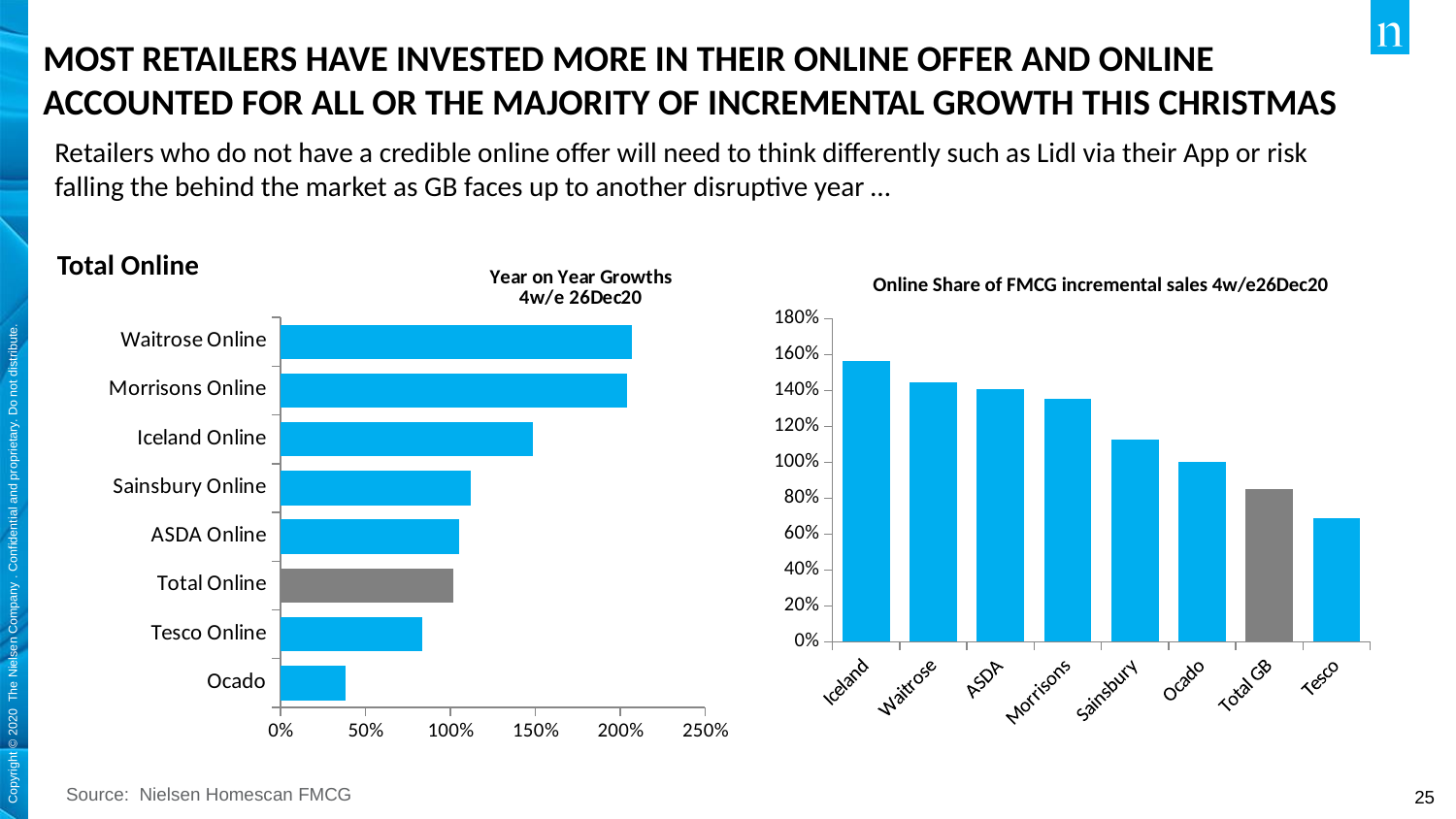
In the 'Year on Year Growths 4w/e 26Dec20' chart, which is larger, Iceland Online or Tesco Online? Iceland Online In the 'Online Share of FMCG incremental sales 4w/e26Dec20' chart, is the value for Total GB greater or less than 100%? less What kind of chart is the 'Year on Year Growths 4w/e 26Dec20' chart on the left? bar chart In the 'Year on Year Growths 4w/e 26Dec20' chart, is the value for Ocado greater or less than 50%? less In the 'Year on Year Growths 4w/e 26Dec20' chart, which category has the lowest value? Ocado What is the title of the chart on the right of the slide? Online Share of FMCG incremental sales 4w/e26Dec20 In the 'Online Share of FMCG incremental sales 4w/e26Dec20' chart, which category has the highest value? Iceland How many categories are shown in the 'Online Share of FMCG incremental sales 4w/e26Dec20' chart? 8 In the 'Year on Year Growths 4w/e 26Dec20' chart, which bar is coloured grey rather than blue? Total Online In the 'Year on Year Growths 4w/e 26Dec20' chart, is the value for Iceland Online greater or less than 100%? greater In the 'Online Share of FMCG incremental sales 4w/e26Dec20' chart, which category has the lowest value? Tesco How many categories are shown in the 'Year on Year Growths 4w/e 26Dec20' chart? 8